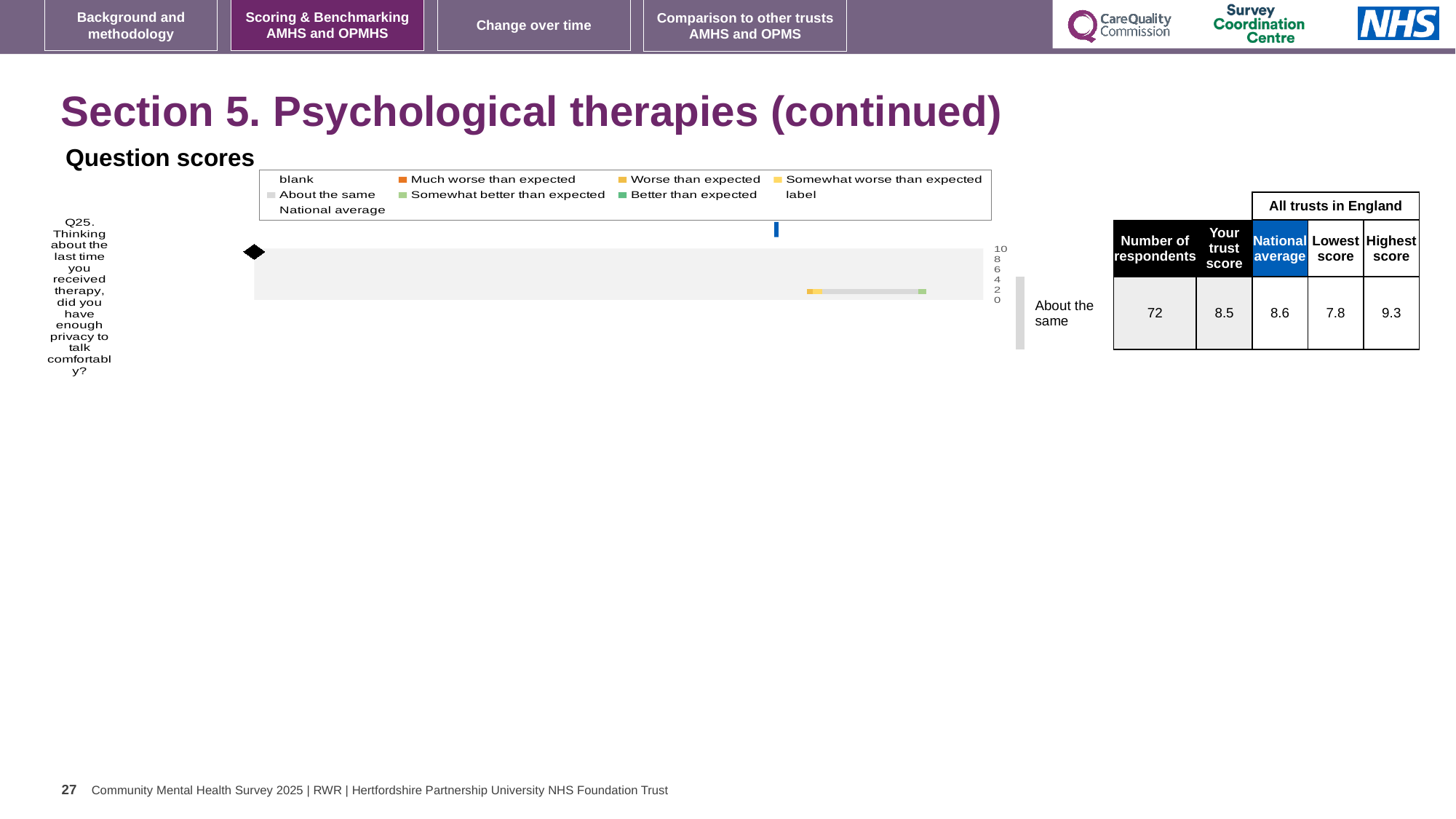
How many entries does the legend of the question scores chart list? 9 What kind of chart is used to show the Q25 question score? bar chart What is the lowest score among all trusts in England for Q25? 7.8 What is the national average score for Q25? 8.6 How many respondents answered Q25? 72 Which benchmark category is Q25 assigned to in the question scores chart? About the same What is the highest value shown on the score axis of the question scores chart? 10 For Q25, which is larger: the trust's score or the national average? National average How many survey questions are plotted in the question scores chart? 1 What is the highest score among all trusts in England for Q25? 9.3 What is the difference between the highest score and the lowest score for Q25 across all trusts in England? 1.5 What is the trust's score for Q25 in the question scores table? 8.5